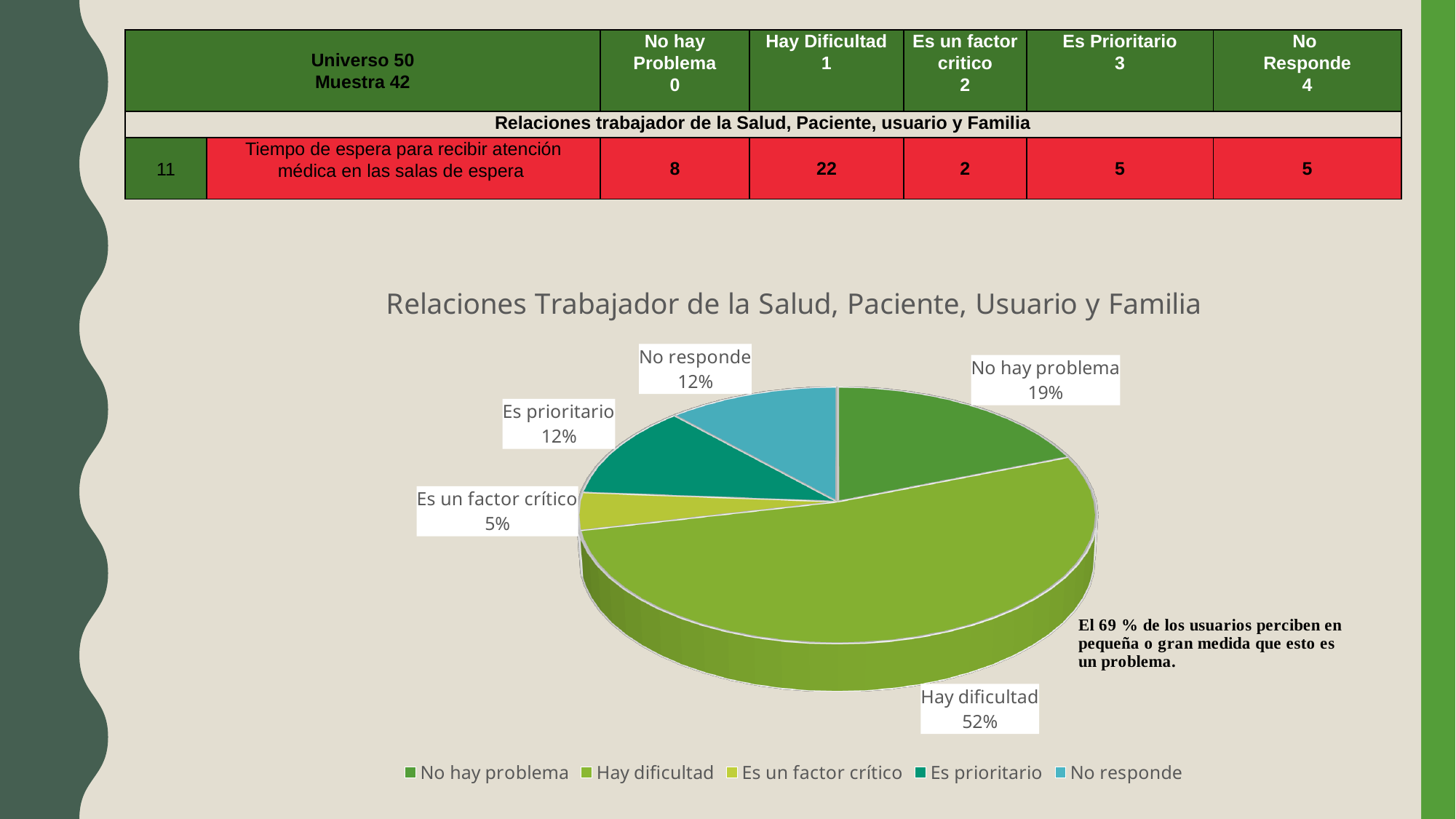
Which category has the smallest slice in the pie chart? Es un factor crítico What kind of chart is shown on the slide? Pie chart What percentage does the 'Es prioritario' slice represent in the pie chart? 12% What is the title of the pie chart? Relaciones Trabajador de la Salud, Paciente, Usuario y Familia Which category has the largest slice in the pie chart? Hay dificultad What percentage does the 'Es un factor crítico' slice represent in the pie chart? 5% What percentage does the 'No hay problema' slice represent in the pie chart? 19% What percentage does the 'Hay dificultad' slice represent in the pie chart? 52% How many slices does the pie chart have? 5 How many entries does the legend of the pie chart list? 5 Which slice is larger in the pie chart, 'No hay problema' or 'No responde'? No hay problema What is the difference in percentage points between the 'Hay dificultad' slice and the 'No hay problema' slice? 33